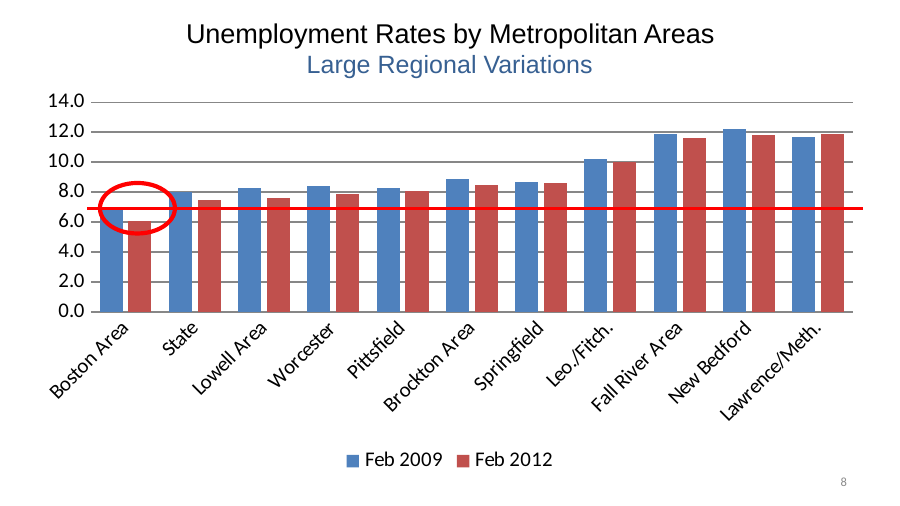
Is the Feb 2012 value for Fall River Area greater or less than 10.0? greater What is the subtitle shown below the chart title? Large Regional Variations Is the Feb 2012 value for Boston Area greater or less than 8.0? less For Boston Area, which is larger: the Feb 2009 value or the Feb 2012 value? Feb 2009 Is the Feb 2009 value for New Bedford greater or less than 10.0? greater How many metropolitan areas (categories) are shown on the x axis? 11 Which category has the lowest Feb 2009 unemployment rate? Boston Area Which is larger: the Feb 2009 value for Fall River Area or the Feb 2009 value for Springfield? Fall River Area Which category has the lowest Feb 2012 unemployment rate? Boston Area What kind of chart is shown on the slide? bar chart How many series does the legend list? 2